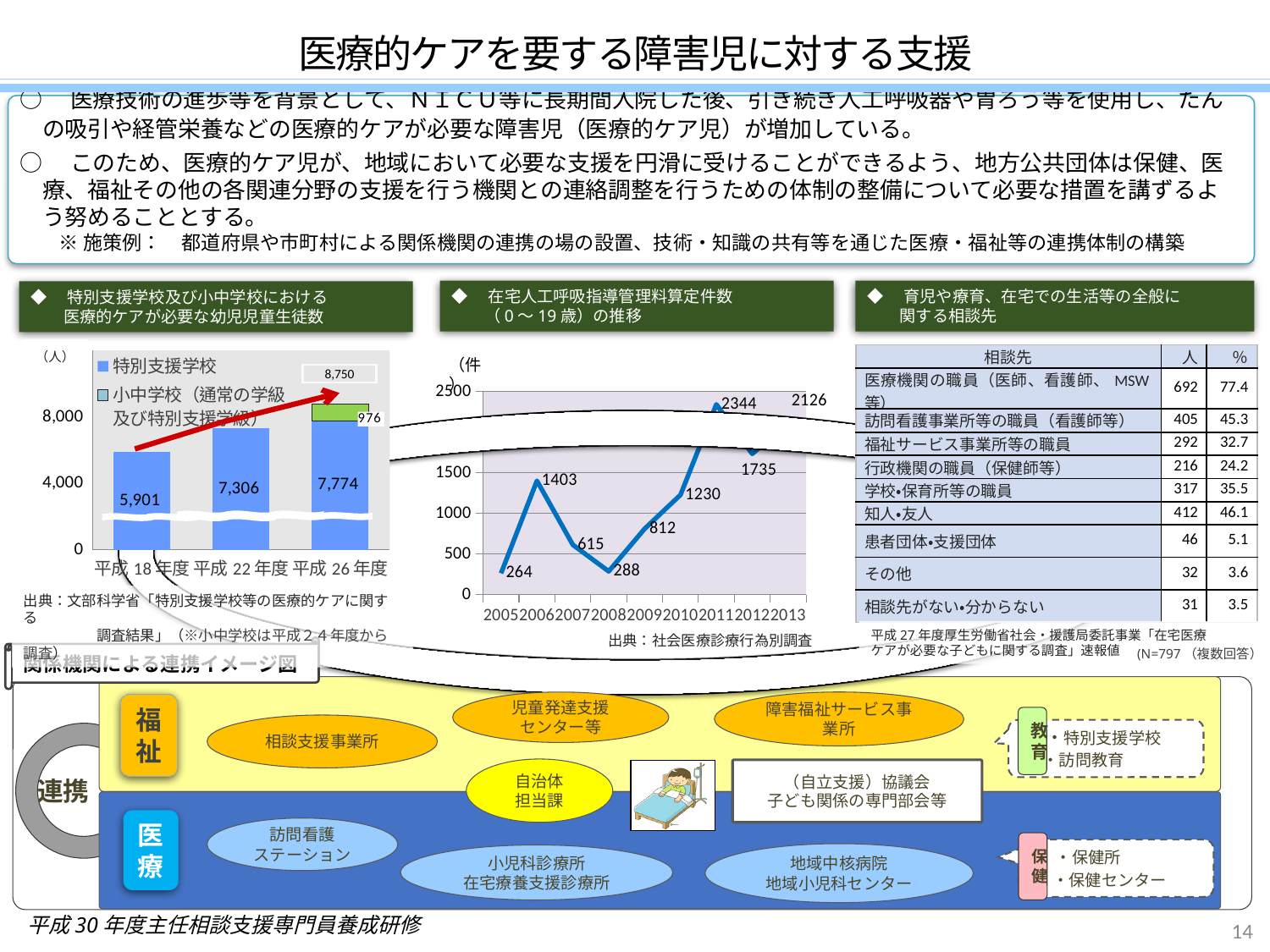
In the left bar chart (特別支援学校及び小中学校における医療的ケアが必要な幼児児童生徒数), what is the total of the stacked bar for 平成26年度? 8,750 In the middle line chart (在宅人工呼吸指導管理料算定件数（0～19歳）の推移), which year has the lowest value? 2005 In the middle line chart (在宅人工呼吸指導管理料算定件数（0～19歳）の推移), which is larger, the value for 2006 or the value for 2010? 2006 In the left bar chart (特別支援学校及び小中学校における医療的ケアが必要な幼児児童生徒数), what is the difference between the 特別支援学校 values for 平成22年度 and 平成18年度? 1,405 In the left bar chart (特別支援学校及び小中学校における医療的ケアが必要な幼児児童生徒数), what is the value for 小中学校 in 平成26年度? 976 In the middle line chart (在宅人工呼吸指導管理料算定件数（0～19歳）の推移), how many years are plotted? 9 In the middle line chart (在宅人工呼吸指導管理料算定件数（0～19歳）の推移), what is the value for 2011? 2344 In the left bar chart (特別支援学校及び小中学校における医療的ケアが必要な幼児児童生徒数), do the 特別支援学校 values rise or fall from 平成18年度 to 平成26年度? rise In the left bar chart (特別支援学校及び小中学校における医療的ケアが必要な幼児児童生徒数), what is the value for 特別支援学校 in 平成18年度? 5,901 In the left bar chart (特別支援学校及び小中学校における医療的ケアが必要な幼児児童生徒数), how many series does the legend list? 2 In the middle line chart (在宅人工呼吸指導管理料算定件数（0～19歳）の推移), which year has the highest value? 2011 In the left bar chart (特別支援学校及び小中学校における医療的ケアが必要な幼児児童生徒数), what is the value for 特別支援学校 in 平成26年度? 7,774